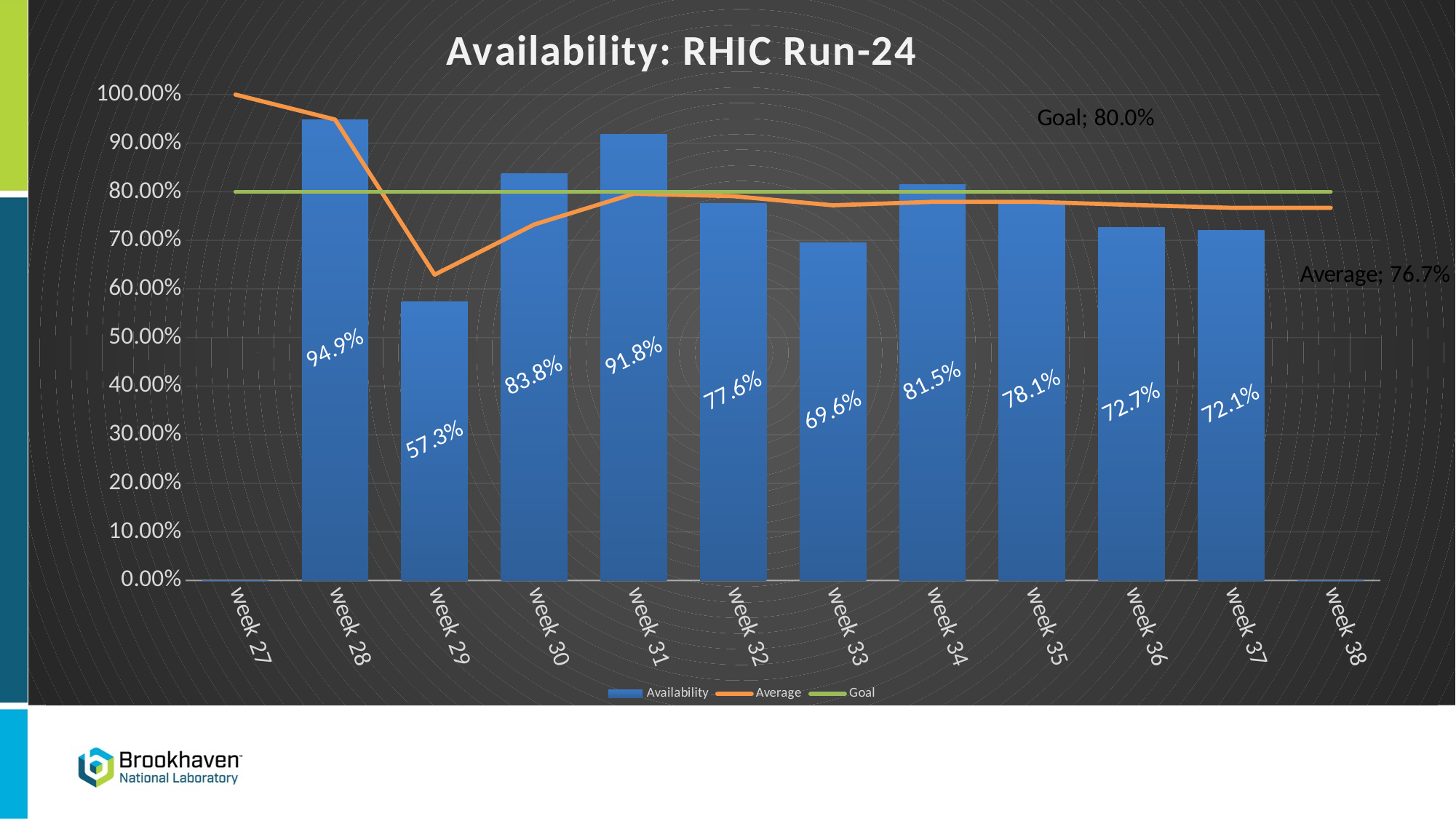
Which has the higher availability, week 30 or week 34? week 30 What is the availability value for week 28? 94.9% How many weeks have an availability bar plotted? 10 Which week has the lowest availability? week 29 What is the Goal value shown on the chart? 80.0% What is the availability value for week 33? 69.6% Do the availability values rise or fall from week 34 to week 37? fall Is the Average line value at week 29 greater or less than 70.00%? less What is the difference between the availability for week 28 and week 29? 37.6 percentage points How many series does the legend list? 3 What kind of chart is this? Bar chart with line series Which week has the highest availability? week 28